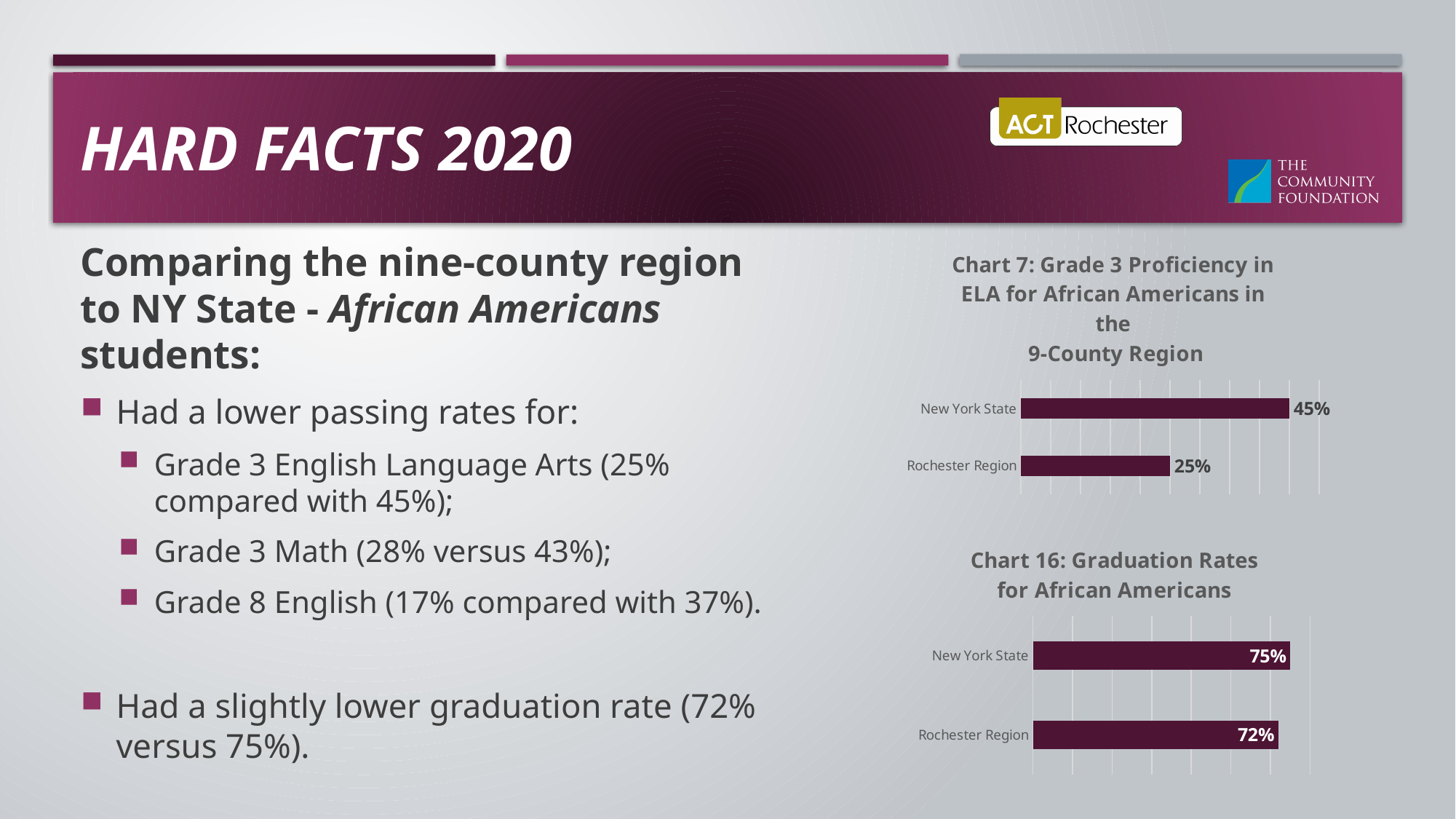
In Chart 16 (Graduation Rates for African Americans), which category has the lower value? Rochester Region In Chart 7 (Grade 3 Proficiency in ELA), what is the difference between the New York State and Rochester Region values? 20% In Chart 7 (Grade 3 Proficiency in ELA for African Americans), what is the value for Rochester Region? 25% In Chart 7 (Grade 3 Proficiency in ELA), how many categories are plotted? 2 What kind of chart is Chart 7 (Grade 3 Proficiency in ELA)? Bar chart In Chart 7 (Grade 3 Proficiency in ELA for African Americans), what is the value for New York State? 45% In Chart 16 (Graduation Rates for African Americans), is the value for New York State larger or smaller than the value for Rochester Region? Larger What is the title of the lower chart on the slide? Chart 16: Graduation Rates for African Americans In Chart 7 (Grade 3 Proficiency in ELA), which category has the higher value? New York State In Chart 16 (Graduation Rates for African Americans), what is the value for New York State? 75% In Chart 16 (Graduation Rates for African Americans), what is the difference between the New York State and Rochester Region values? 3% In Chart 16 (Graduation Rates for African Americans), what is the value for Rochester Region? 72%